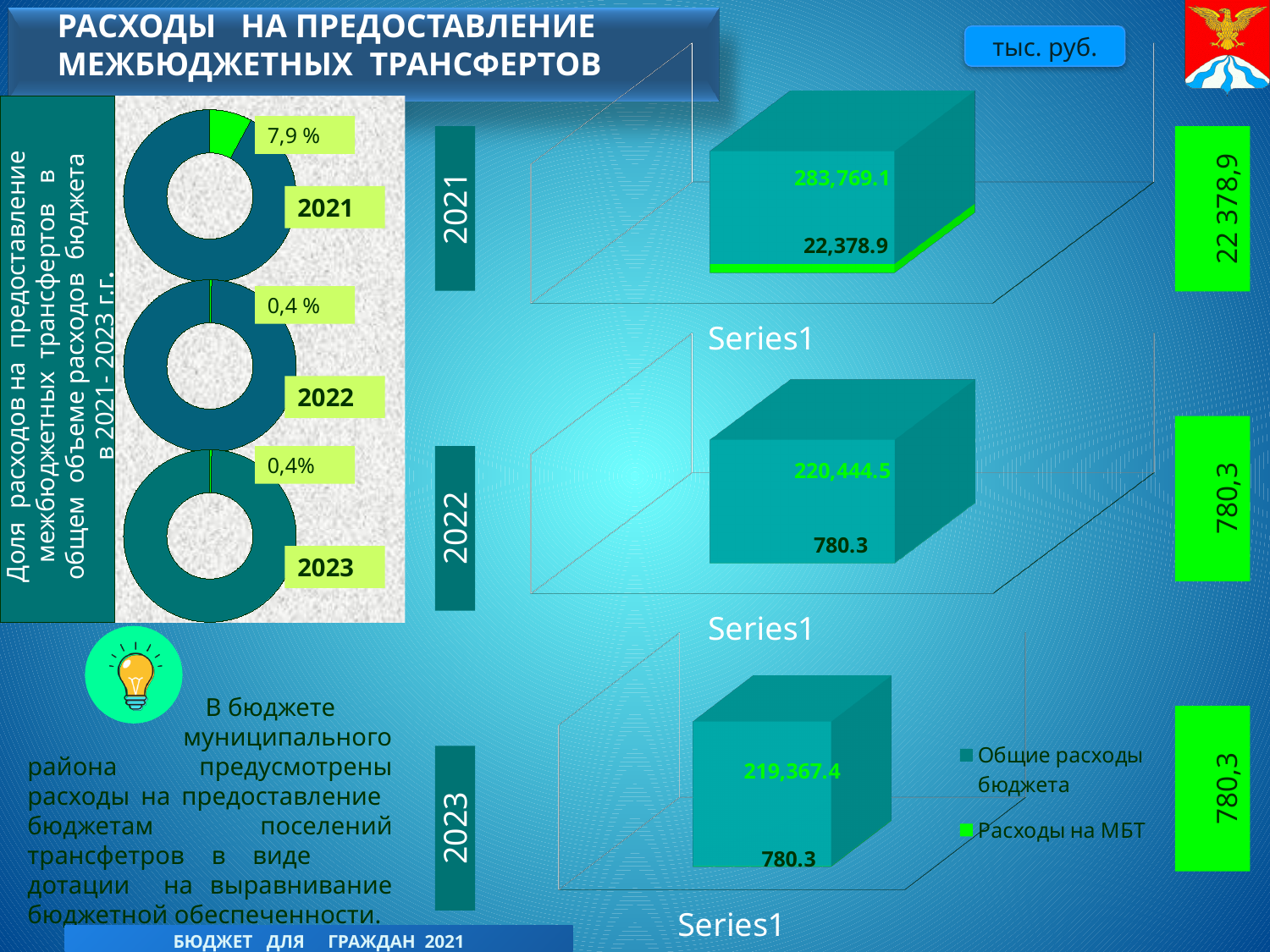
How many series does the legend of the bar charts list? 2 In the 2021 bar chart, what is the value labelled for Расходы на МБТ? 22,378.9 In the 2022 bar chart, what is the value labelled for Расходы на МБТ? 780.3 In the 2021 bar chart, what is the value labelled for Общие расходы бюджета? 283,769.1 In the donut chart for 2021 on the left, what share is labelled for the green slice? 7,9 % What unit is shown for the bar chart values in the box at the top right? тыс. руб. In the 2023 bar chart, what is the value labelled for Общие расходы бюджета? 219,367.4 What is the difference between Общие расходы бюджета in 2021 (283,769.1) and in 2022 (220,444.5)? 63,324.6 In the 2021 bar chart, which is larger: Общие расходы бюджета or Расходы на МБТ? Общие расходы бюджета In the 2023 bar chart, what is the value labelled for Расходы на МБТ? 780.3 In the donut chart for 2022 on the left, what share is labelled? 0,4 % In the 2022 bar chart, what is the value labelled for Общие расходы бюджета? 220,444.5